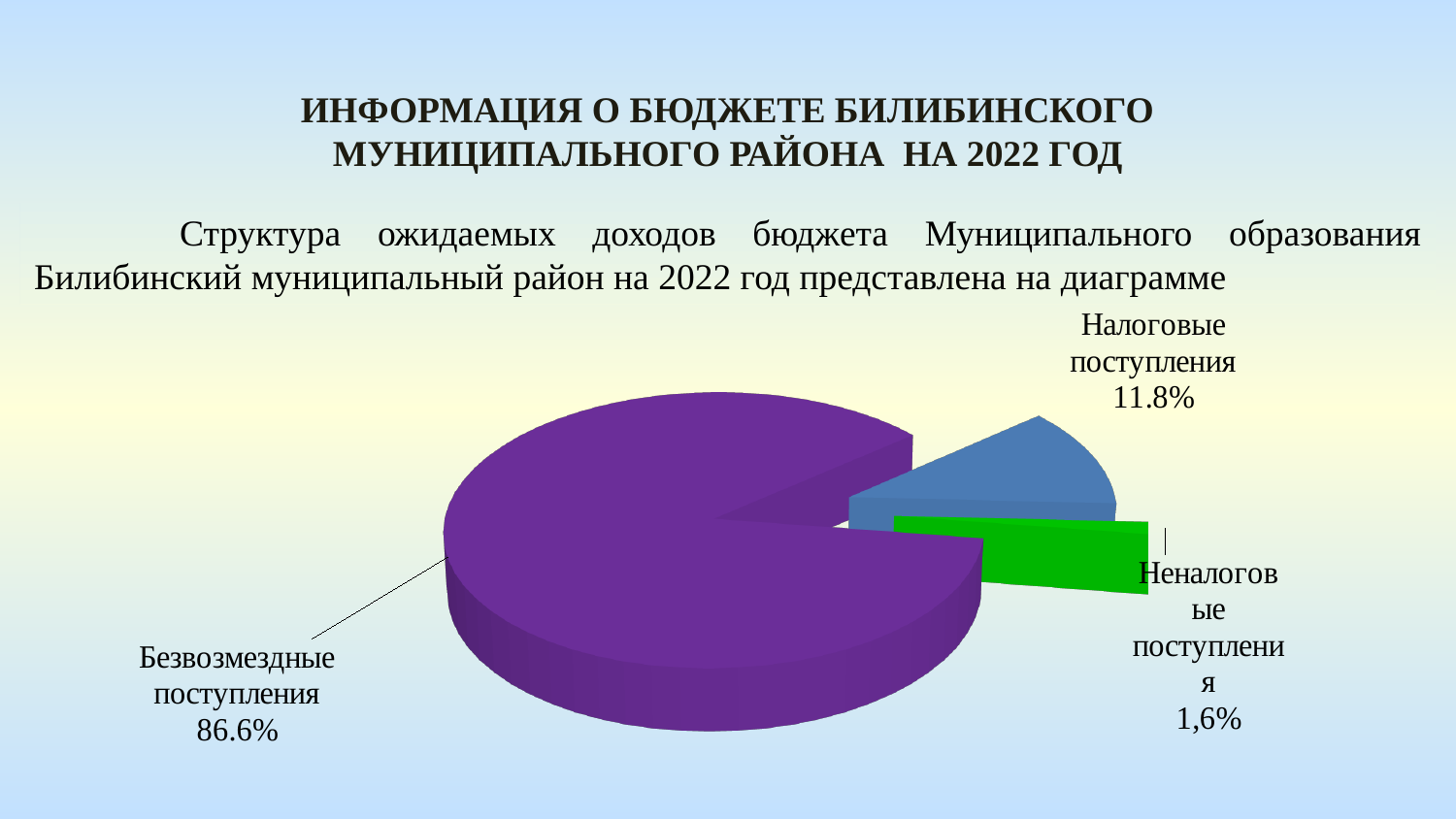
What is the difference in percentage points between Налоговые поступления and Неналоговые поступления? 10.2 What share of the pie does Безвозмездные поступления represent? 86.6% What is the value shown for Налоговые поступления? 11.8% What colour is the slice for Безвозмездные поступления? Purple What is the difference in percentage points between Безвозмездные поступления and Налоговые поступления? 74.8 Which category has the largest slice of the pie? Безвозмездные поступления How many categories are shown in the pie chart? 3 What is the value shown for Неналоговые поступления? 1,6% What kind of chart is shown on the slide? Pie chart Which category has the smallest slice of the pie? Неналоговые поступления What colour is the slice for Неналоговые поступления? Green Which is larger: Налоговые поступления or Неналоговые поступления? Налоговые поступления